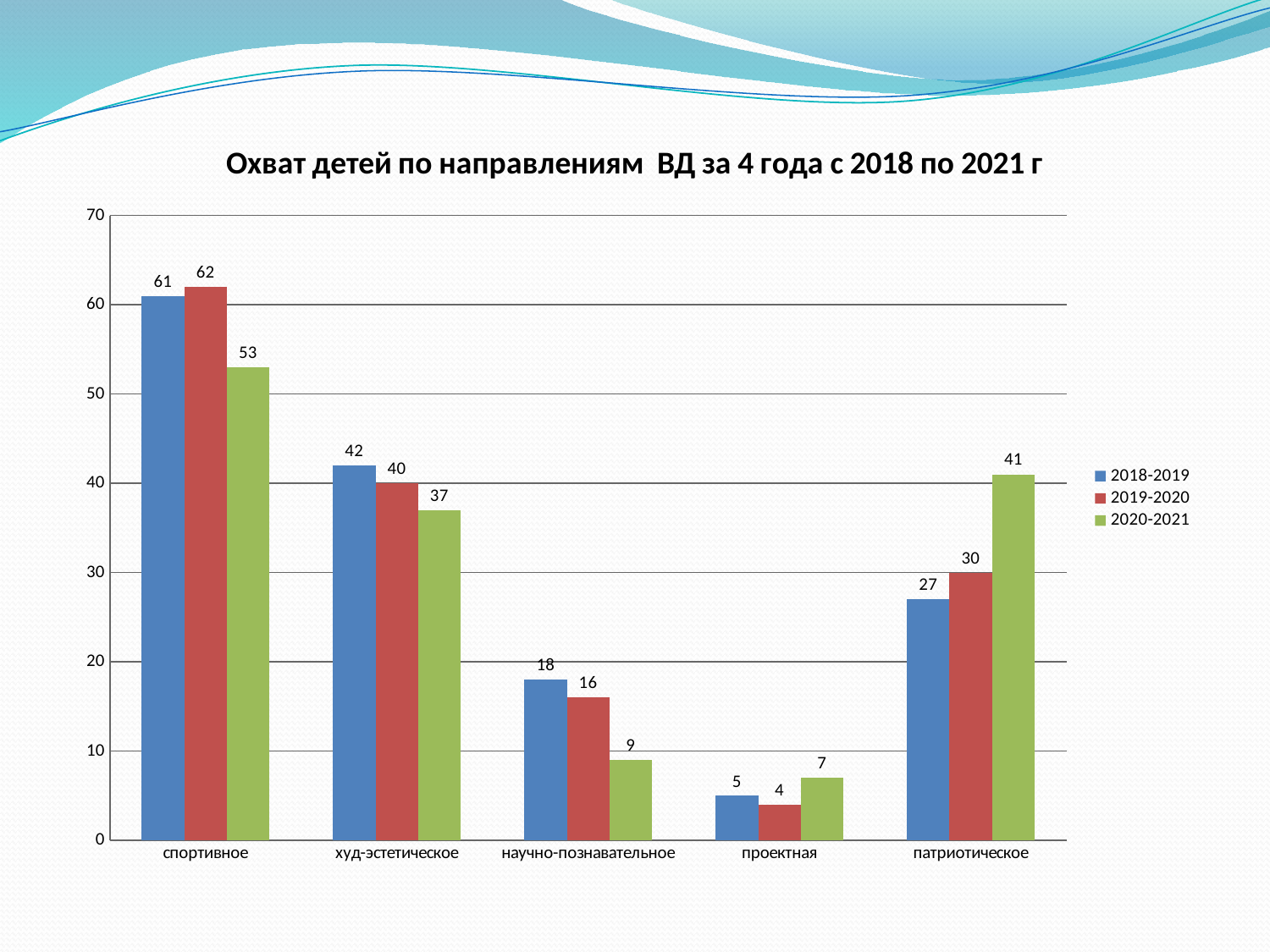
What kind of chart is shown on the slide? bar chart What is the value for патриотическое in the 2020-2021 series? 41 Which colour represents the 2020-2021 series? green Which category has the lowest value in the 2020-2021 series? проектная How many series does the legend list? 3 What is the value for проектная in the 2019-2020 series? 4 How many categories are shown on the x axis? 5 What is the title of the chart? Охват детей по направлениям ВД за 4 года с 2018 по 2021 г What is the value for спортивное in the 2018-2019 series? 61 Which category has the highest value in the 2019-2020 series? спортивное What is the difference between the 2018-2019 and 2020-2021 values for научно-познавательное? 9 Which is larger for худ-эстетическое: the 2018-2019 value or the 2020-2021 value? 2018-2019